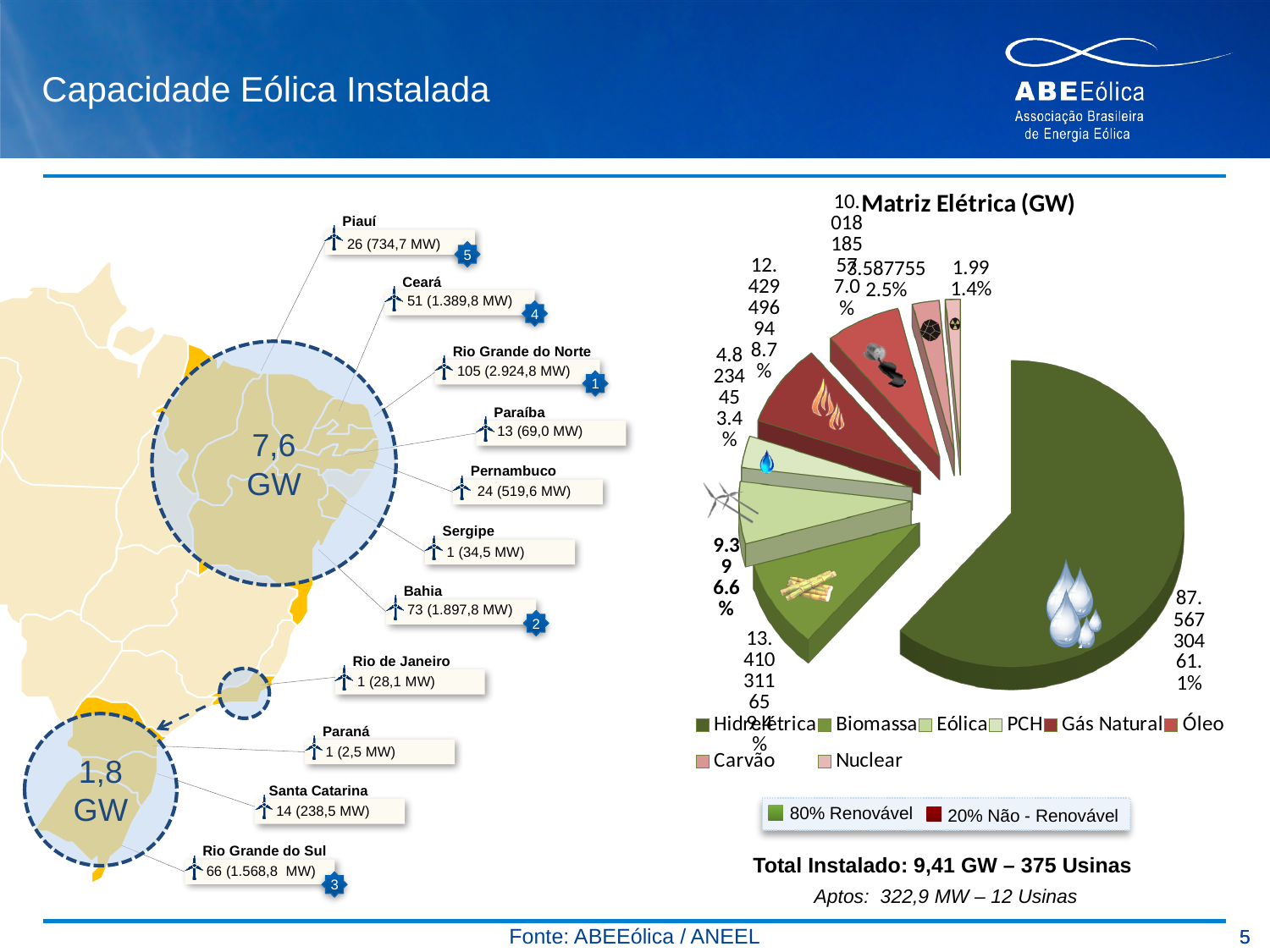
In the 'Matriz Elétrica (GW)' pie chart, what percentage share does Hidrelétrica have? 61.1% In the 'Matriz Elétrica (GW)' pie chart, what percentage share does Gás Natural have? 8.7% How many categories does the legend of the 'Matriz Elétrica (GW)' pie chart list? 8 What kind of chart is the 'Matriz Elétrica (GW)' chart? pie chart In the 'Matriz Elétrica (GW)' pie chart, what percentage share does Eólica have? 6.6% In the 'Matriz Elétrica (GW)' pie chart, which category has the smallest slice? Nuclear In the 'Matriz Elétrica (GW)' pie chart, which category has the largest slice? Hidrelétrica In the 'Matriz Elétrica (GW)' pie chart, which slice is larger, Gás Natural or Óleo? Gás Natural What is the title of the pie chart on the right side of the slide? Matriz Elétrica (GW)